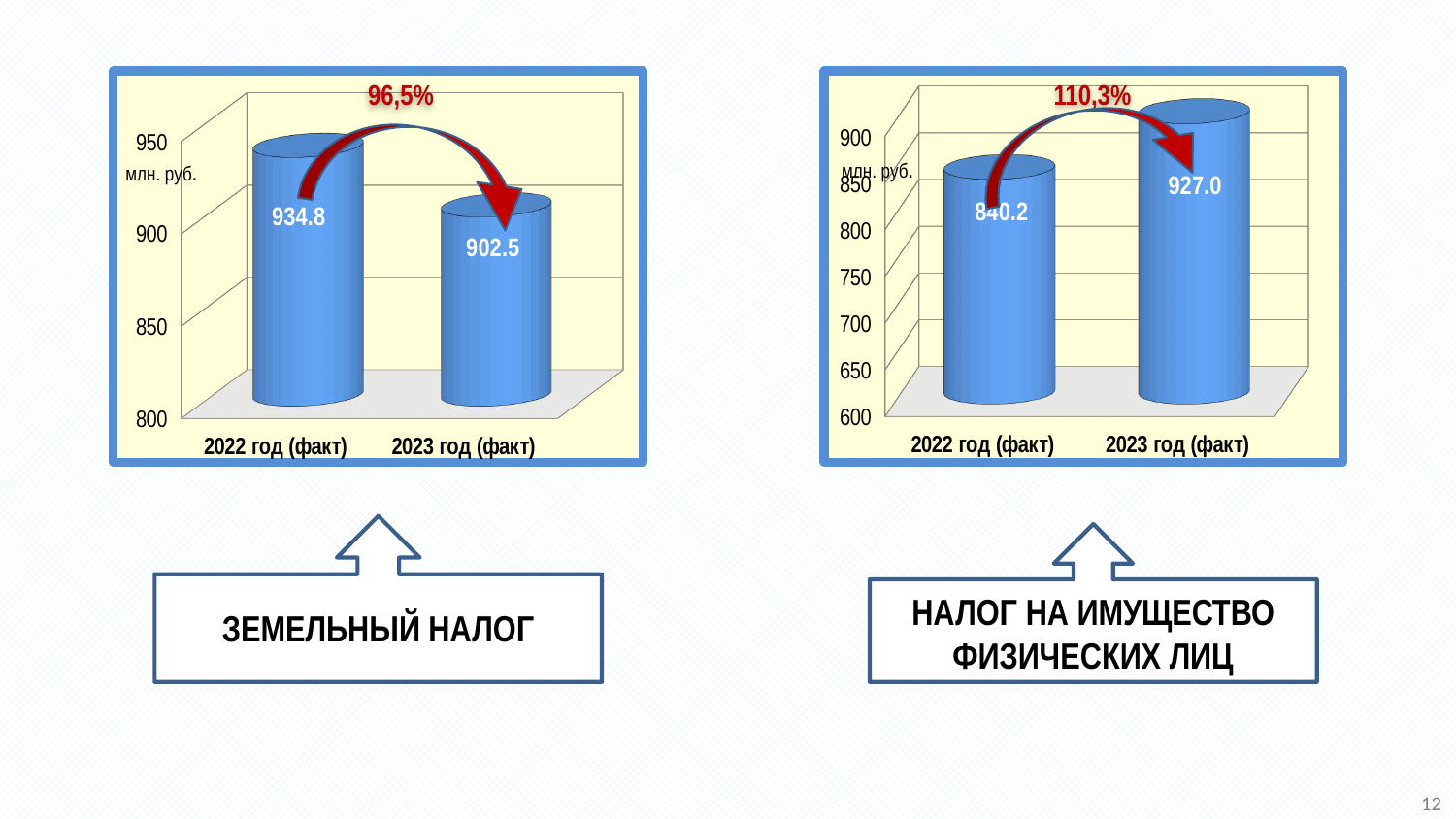
In the right chart (НАЛОГ НА ИМУЩЕСТВО ФИЗИЧЕСКИХ ЛИЦ), which year has the lower value? 2022 год (факт) In the right chart (НАЛОГ НА ИМУЩЕСТВО ФИЗИЧЕСКИХ ЛИЦ), what is the value for 2022 год (факт)? 840.2 In the right chart (НАЛОГ НА ИМУЩЕСТВО ФИЗИЧЕСКИХ ЛИЦ), what is the difference between the 2023 and 2022 values? 86.8 In the left chart (ЗЕМЕЛЬНЫЙ НАЛОГ), what is the value for 2023 год (факт)? 902.5 In the left chart (ЗЕМЕЛЬНЫЙ НАЛОГ), what is the value for 2022 год (факт)? 934.8 What kind of chart is the left chart (ЗЕМЕЛЬНЫЙ НАЛОГ)? bar chart In the right chart (НАЛОГ НА ИМУЩЕСТВО ФИЗИЧЕСКИХ ЛИЦ), do the values rise or fall from 2022 to 2023? rise In the right chart (НАЛОГ НА ИМУЩЕСТВО ФИЗИЧЕСКИХ ЛИЦ), what is the value for 2023 год (факт)? 927.0 In the left chart (ЗЕМЕЛЬНЫЙ НАЛОГ), what is the difference between the 2022 and 2023 values? 32.3 In the left chart (ЗЕМЕЛЬНЫЙ НАЛОГ), which year has the higher value? 2022 год (факт) What percentage is shown above the arrow in the right chart (НАЛОГ НА ИМУЩЕСТВО ФИЗИЧЕСКИХ ЛИЦ)? 110,3% In the left chart (ЗЕМЕЛЬНЫЙ НАЛОГ), do the values rise or fall from 2022 to 2023? fall